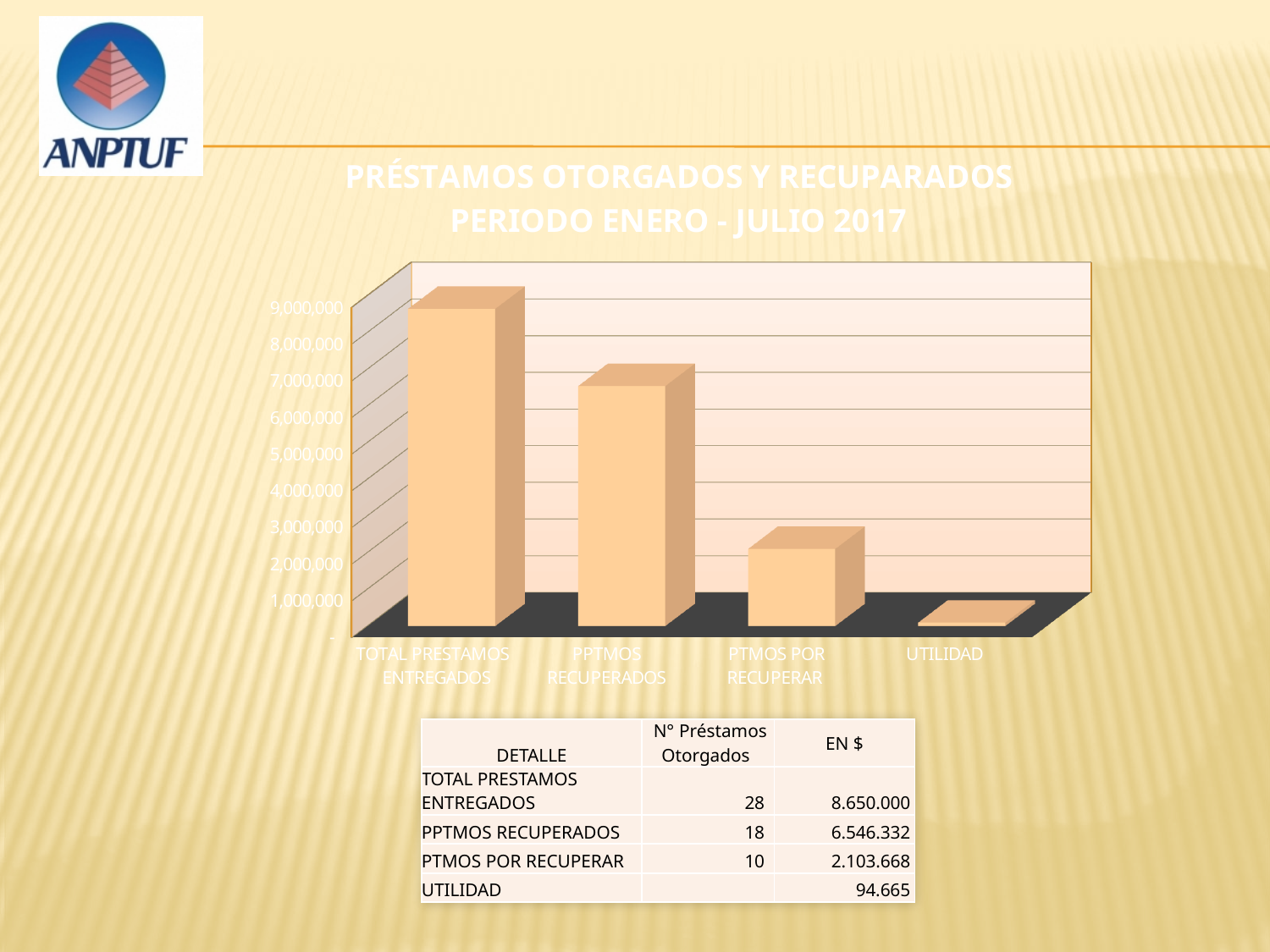
What kind of chart is shown on the slide? bar chart Is the value for PTMOS POR RECUPERAR greater or less than 3,000,000? less Is the value for UTILIDAD greater or less than 1,000,000? less Which category has the lowest bar in the chart? UTILIDAD Do the bar values rise or fall from left to right across the categories? fall Is the value for TOTAL PRESTAMOS ENTREGADOS greater or less than 8,000,000? greater Which category has the highest bar in the chart? TOTAL PRESTAMOS ENTREGADOS What is the title of the chart? PRÉSTAMOS OTORGADOS Y RECUPARADOS PERIODO ENERO - JULIO 2017 According to the table below the chart, what is the EN $ value for PPTMOS RECUPERADOS? 6.546.332 Which is larger, the bar for PPTMOS RECUPERADOS or the bar for PTMOS POR RECUPERAR? PPTMOS RECUPERADOS How many categories are plotted in the chart? 4